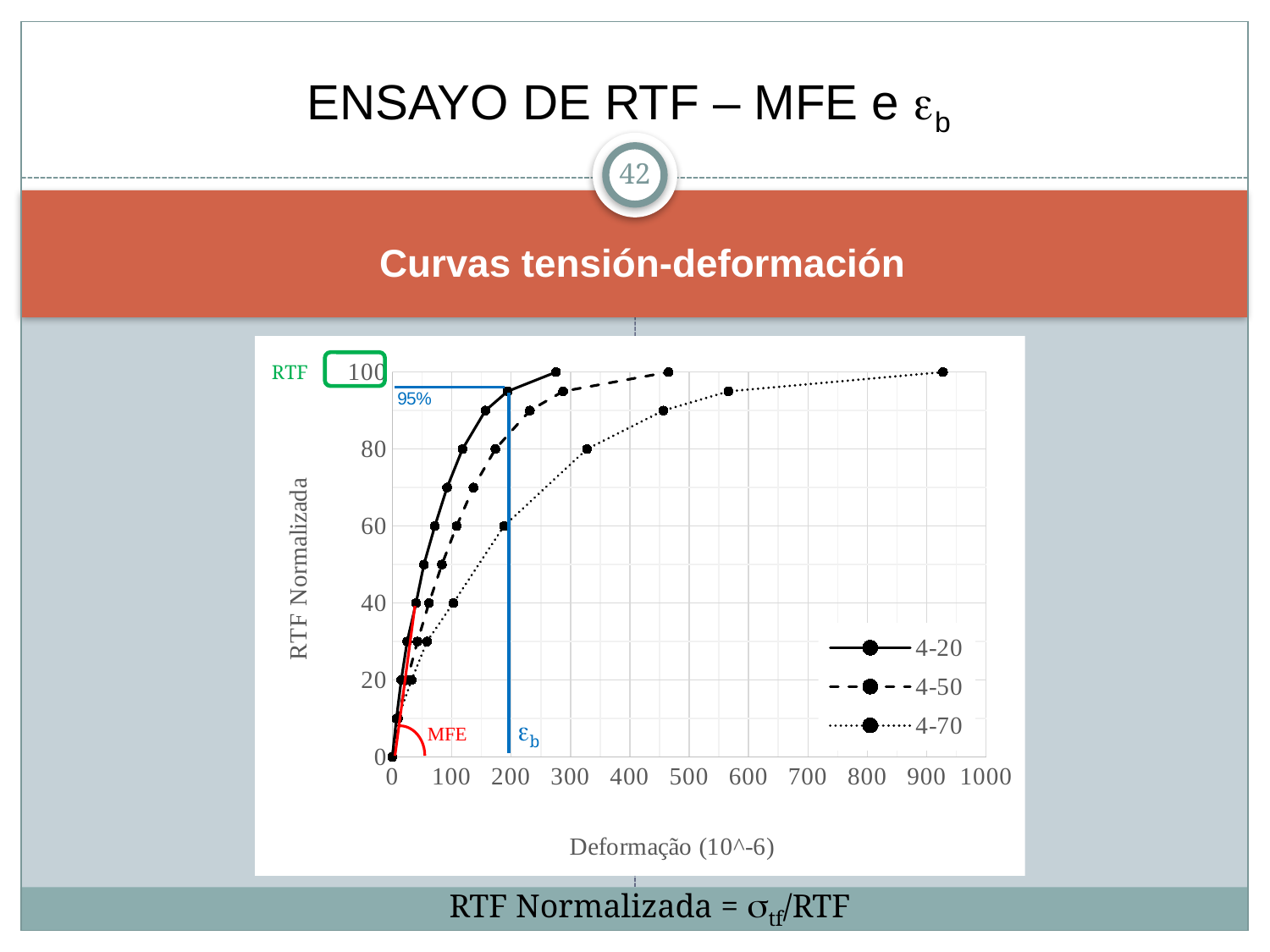
At a deformation of 100, which series has the higher RTF Normalizada, 4-20 or 4-70? 4-20 Which series reaches RTF Normalizada 100 at the smallest deformation? 4-20 Which series reaches RTF Normalizada 100 at the largest deformation? 4-70 What are the names of the series in the legend? 4-20, 4-50, 4-70 Is the RTF Normalizada of the 4-70 series at a deformation of 500 greater or less than 80? greater How many series does the legend list? 3 Is the deformation at which the 4-20 series reaches 100 greater or less than 300? less Do the values of the 4-20 series rise or fall as deformation increases? Rise What is the title of the y axis? RTF Normalizada Is the deformation at which the 4-50 series reaches 100 greater or less than 400? greater What type of chart is shown on the slide? Line chart